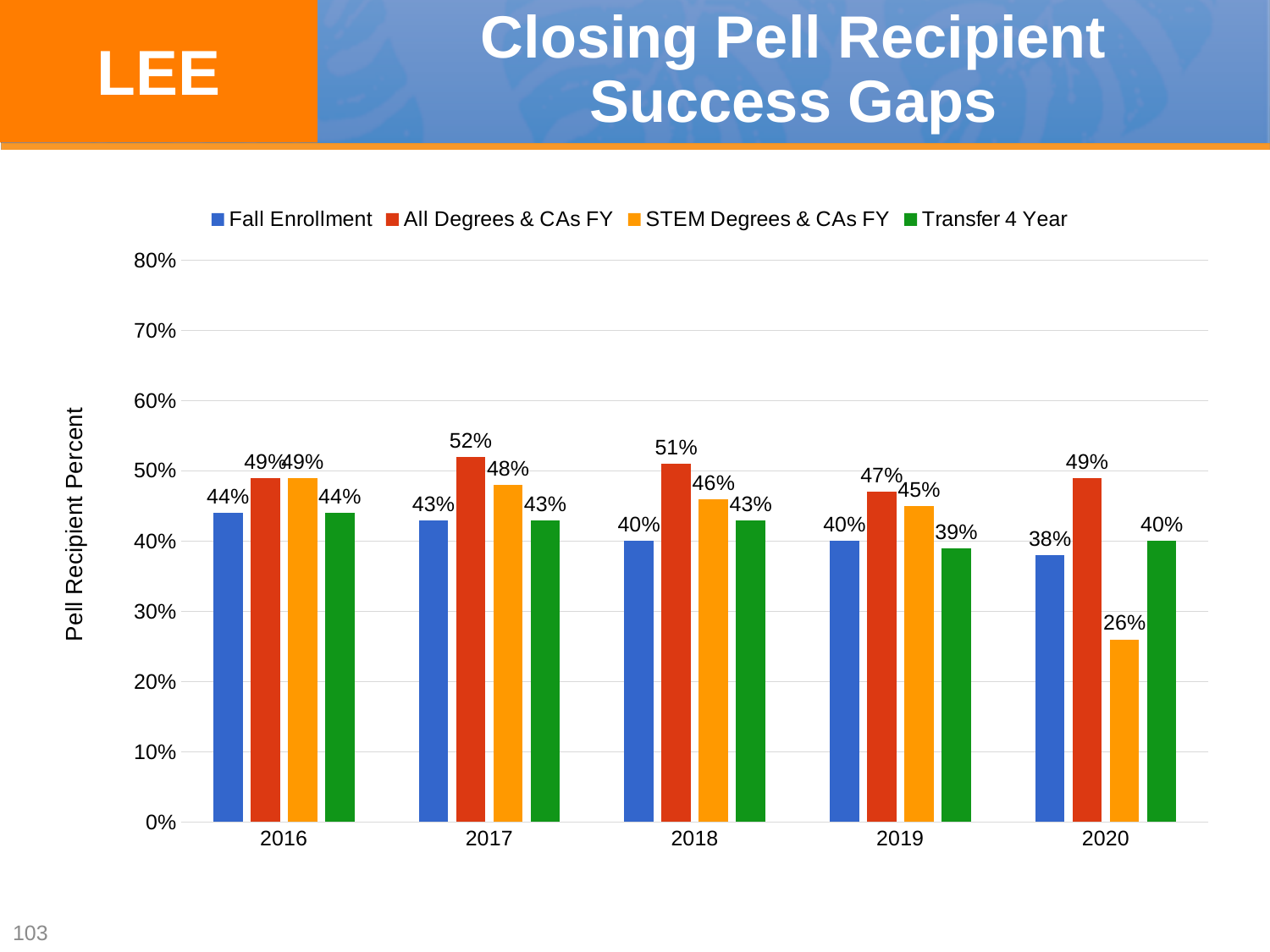
What is the All Degrees & CAs FY value for 2017? 52% What kind of chart is shown on the slide? Bar chart What is the Transfer 4 Year value for 2019? 39% How many series does the legend list? 4 What is the difference between the All Degrees & CAs FY value and the Fall Enrollment value in 2018? 11% What is the STEM Degrees & CAs FY value for 2020? 26% Does the Fall Enrollment value rise or fall from 2016 to 2020? Fall In which year is the All Degrees & CAs FY value highest? 2017 What is the Fall Enrollment value for 2016? 44% In which year is the STEM Degrees & CAs FY value lowest? 2020 How many years are shown on the x axis? 5 Which is larger in 2020: the Transfer 4 Year value or the STEM Degrees & CAs FY value? Transfer 4 Year